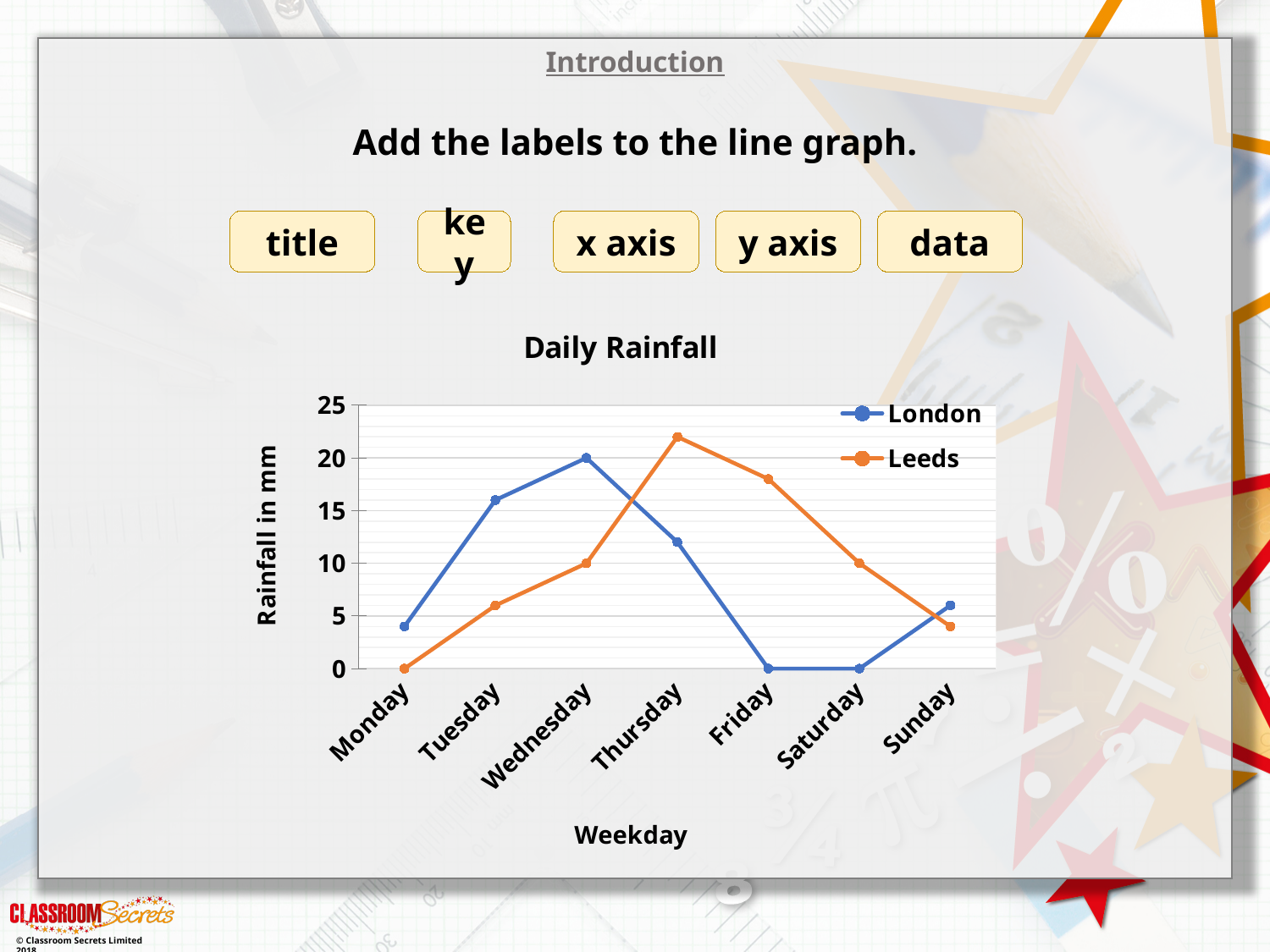
How many weekdays are plotted along the x axis? 7 On which day is the rainfall for London highest? Wednesday What is the rainfall in mm for Leeds on Monday? 0 What is the rainfall in mm for London on Wednesday? 20 What is the rainfall in mm for Leeds on Saturday? 10 On which day is the rainfall for Leeds highest? Thursday Is the rainfall for London on Monday greater or less than 5? less Which has higher rainfall on Friday, London or Leeds? Leeds What is the title of the chart? Daily Rainfall Is the rainfall for Leeds on Thursday greater or less than 20? greater How many series does the legend list? 2 What kind of chart is shown on the slide? line chart